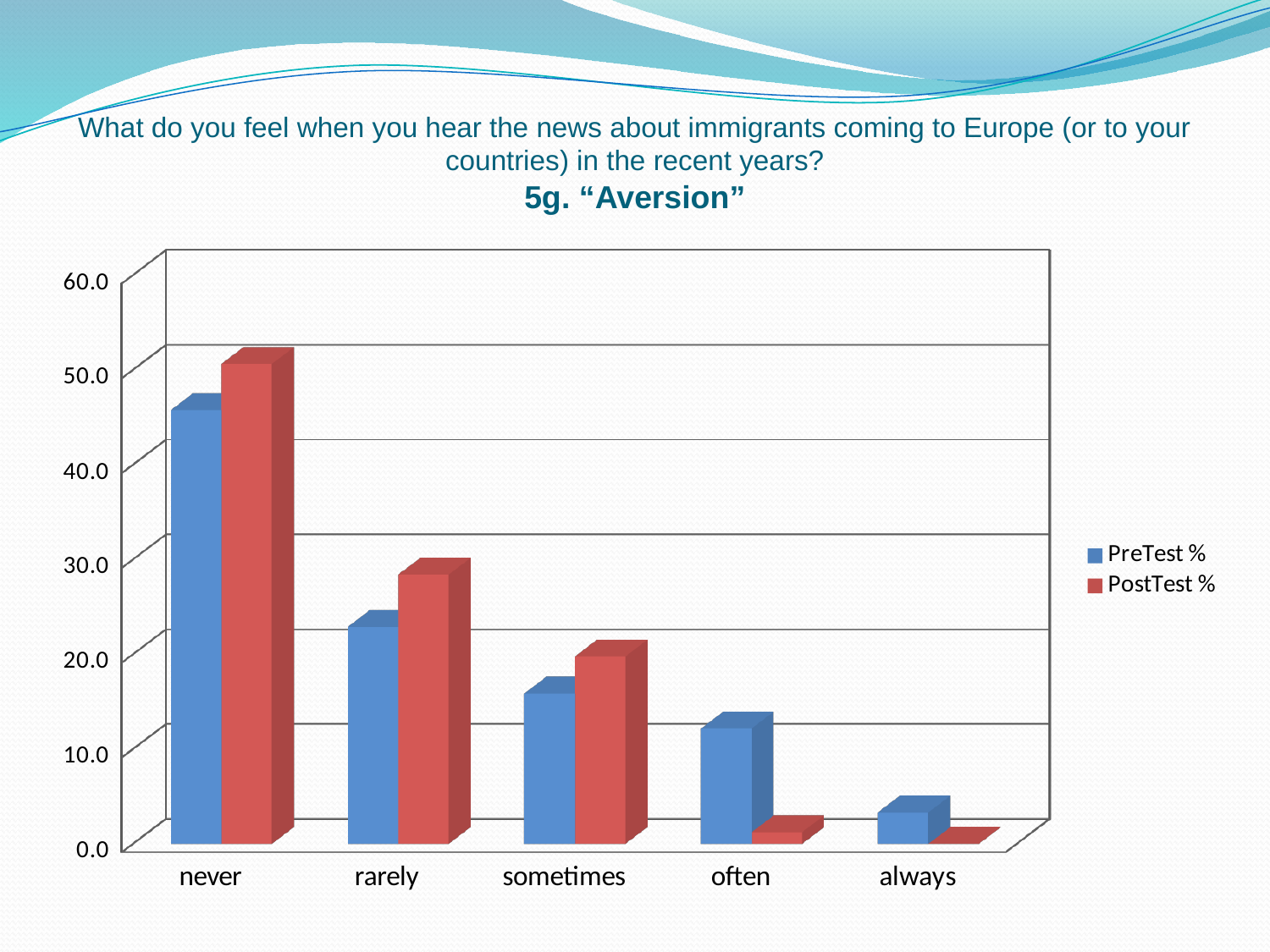
Is the PostTest % value for 'often' greater or less than 10.0? less Which category has the highest PostTest % value? never Which category has the highest PreTest % value? never Is the PostTest % value for 'rarely' greater or less than 20.0? greater Do the PreTest % values rise or fall moving from 'never' to 'always' along the x axis? fall Which category has the lowest PreTest % value? always How many series does the legend list? 2 How many categories are shown on the x axis? 5 For the category 'never', which series has the larger value, PreTest % or PostTest %? PostTest % Is the PreTest % value for 'never' greater or less than 40.0? greater For the category 'often', which series has the larger value, PreTest % or PostTest %? PreTest % What kind of chart is shown on the slide? bar chart